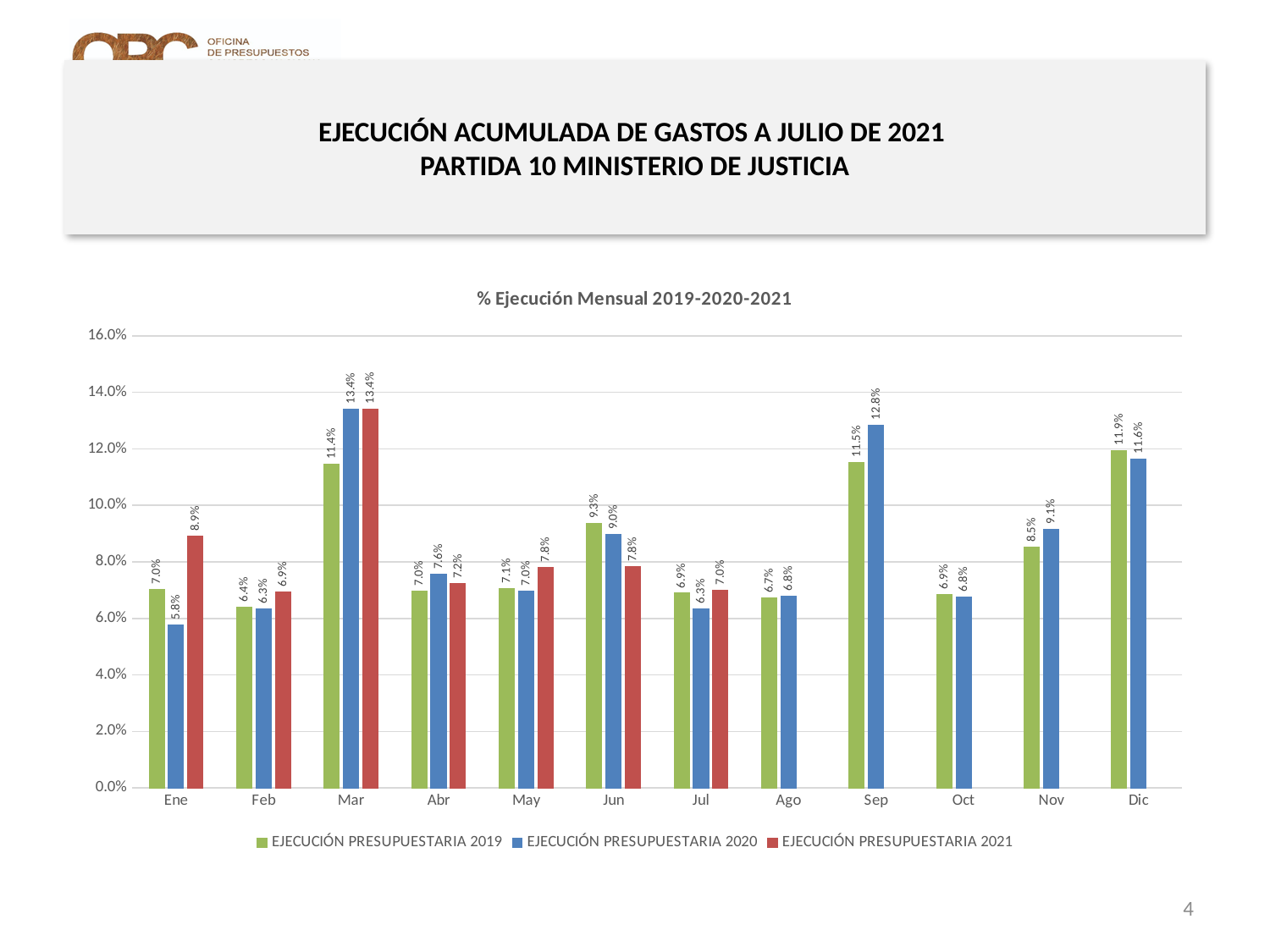
What is the value for EJECUCIÓN PRESUPUESTARIA 2021 in Ene? 8.9% Which is larger in Jun: the EJECUCIÓN PRESUPUESTARIA 2019 value or the EJECUCIÓN PRESUPUESTARIA 2021 value? EJECUCIÓN PRESUPUESTARIA 2019 How many series does the legend list? 3 In which month is the EJECUCIÓN PRESUPUESTARIA 2019 value highest? Dic What is the value for EJECUCIÓN PRESUPUESTARIA 2019 in Dic? 11.9% How many months are shown on the x axis? 12 In which month is the EJECUCIÓN PRESUPUESTARIA 2020 value lowest? Ene What is the difference between the EJECUCIÓN PRESUPUESTARIA 2021 and EJECUCIÓN PRESUPUESTARIA 2019 values in Mar? 2.0% What is the title of the chart? % Ejecución Mensual 2019-2020-2021 Is the EJECUCIÓN PRESUPUESTARIA 2020 value for Nov greater or less than 8.0%? greater What is the value for EJECUCIÓN PRESUPUESTARIA 2020 in Sep? 12.8% What kind of chart is shown on the slide? Bar chart